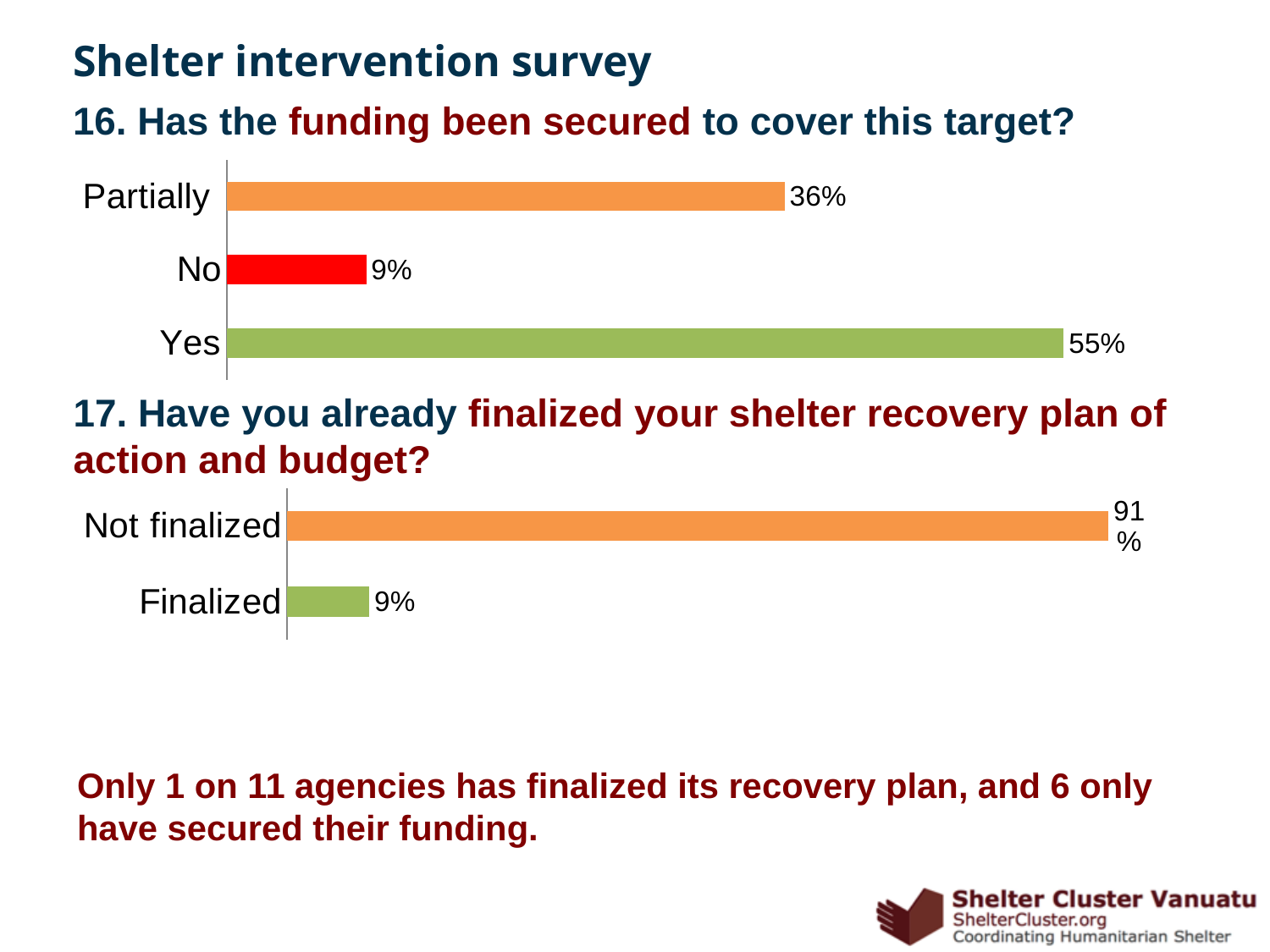
In the chart for question 17 (recovery plan finalized), which is larger, Not finalized or Finalized? Not finalized In the chart for question 17 (recovery plan finalized), what is the value for Not finalized? 91% In the chart for question 16 (funding secured), which category has the highest value? Yes In the chart for question 16 (funding secured), how many categories are shown? 3 In the chart for question 16 (funding secured), what is the value for No? 9% In the chart for question 16 (funding secured), what is the value for Partially? 36% In the chart for question 17 (recovery plan finalized), what is the value for Finalized? 9% In the chart for question 16 (funding secured), which category has the lowest value? No In the chart for question 16 (funding secured), what is the value for Yes? 55% In the chart for question 16 (funding secured), what is the difference between Yes and Partially? 19% What type of chart is used for question 16 (funding secured)? Bar chart In the chart for question 17 (recovery plan finalized), what is the difference between Not finalized and Finalized? 82%